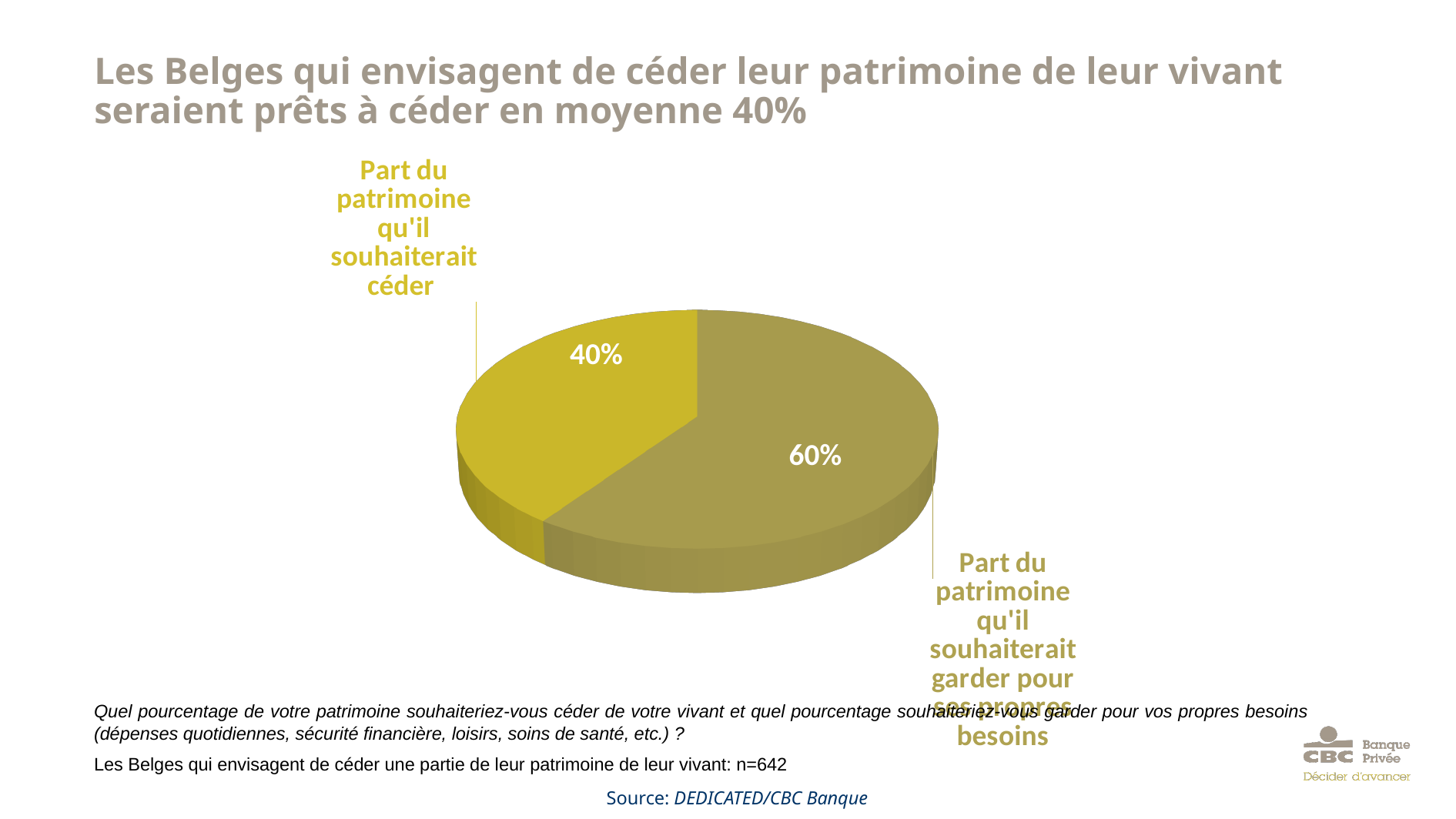
What source is cited for the chart? DEDICATED/CBC Banque What share of the pie is labelled "Part du patrimoine qu'il souhaiterait céder"? 40% Which slice of the pie is the largest? Part du patrimoine qu'il souhaiterait garder pour ses propres besoins Which is larger: the share the respondents would give away or the share they would keep? the share they would keep Which slice of the pie is the smallest? Part du patrimoine qu'il souhaiterait céder What is the sample size (n) stated below the chart? n=642 What kind of chart is shown on the slide? pie chart What share of the pie is labelled "Part du patrimoine qu'il souhaiterait garder pour ses propres besoins"? 60% Is the share labelled "Part du patrimoine qu'il souhaiterait céder" greater or less than 50%? less What is the difference in percentage points between the share to keep and the share to give away? 20 percentage points How many slices does the pie chart have? 2 What is the total of the two slices shown in the pie chart? 100%